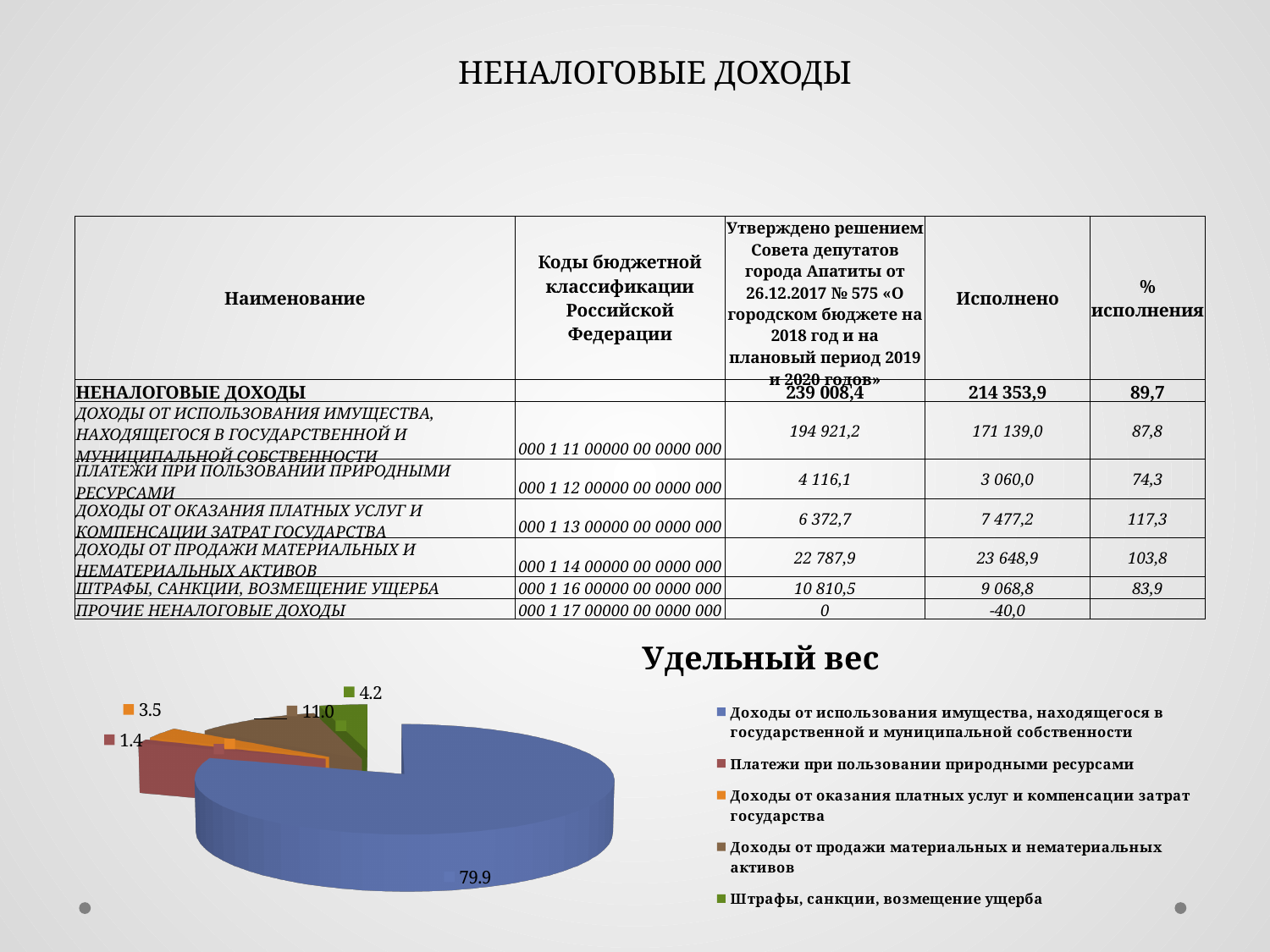
In the "Удельный вес" chart, what value is shown for "Доходы от использования имущества, находящегося в государственной и муниципальной собственности"? 79.9 In the "Удельный вес" chart, what value is shown for "Штрафы, санкции, возмещение ущерба"? 4.2 Which category has the largest slice in the "Удельный вес" pie chart? Доходы от использования имущества, находящегося в государственной и муниципальной собственности How many entries does the legend of the "Удельный вес" chart list? 5 How many slices does the "Удельный вес" pie chart have? 5 What is the title of the chart on the slide? Удельный вес In the "Удельный вес" chart, what value is shown for "Доходы от продажи материальных и нематериальных активов"? 11.0 What kind of chart is shown under the heading "Удельный вес"? pie chart In the "Удельный вес" chart, what is the difference between the value for "Доходы от продажи материальных и нематериальных активов" and the value for "Штрафы, санкции, возмещение ущерба"? 6.8 In the "Удельный вес" chart, which is larger: the slice for "Доходы от оказания платных услуг и компенсации затрат государства" or the slice for "Штрафы, санкции, возмещение ущерба"? Штрафы, санкции, возмещение ущерба Which category has the smallest slice in the "Удельный вес" pie chart? Платежи при пользовании природными ресурсами In the "Удельный вес" chart, what value is shown for "Платежи при пользовании природными ресурсами"? 1.4